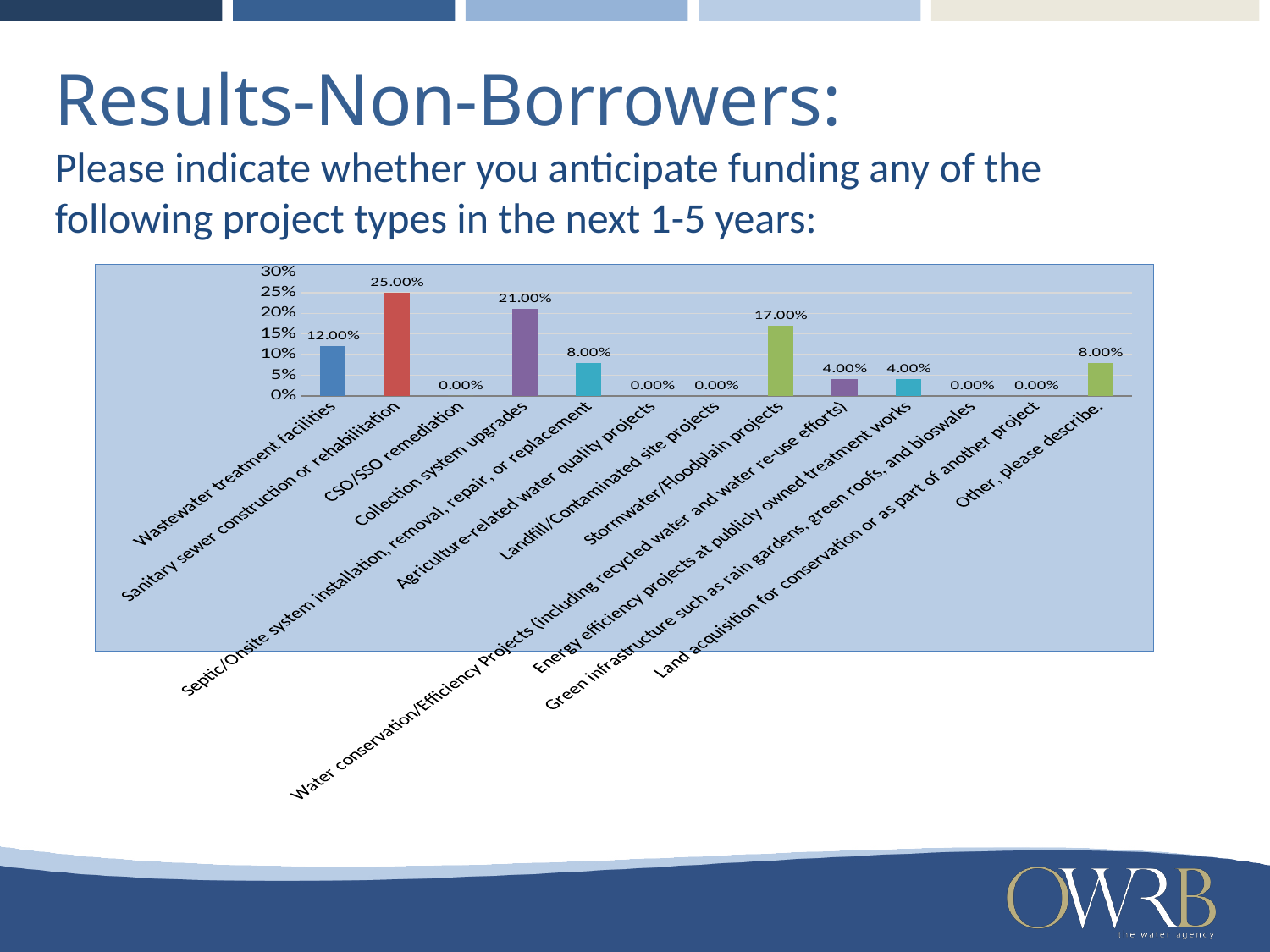
What is the value shown for CSO/SSO remediation? 0.00% What is the value shown for Energy efficiency projects at publicly owned treatment works? 4.00% How many project type categories are shown on the x axis? 13 How many project types have a value of 0.00%? 5 What is the value shown for Collection system upgrades? 21.00% Is the value for Stormwater/Floodplain projects greater or less than 15%? greater What kind of chart is shown on the slide? bar chart What percentage of non-borrowers anticipate funding Wastewater treatment facilities? 12.00% Which is larger, the value for Wastewater treatment facilities or the value for Stormwater/Floodplain projects? Stormwater/Floodplain projects Which project type has the highest value in the chart? Sanitary sewer construction or rehabilitation What is the value shown for Stormwater/Floodplain projects? 17.00% What is the difference between the values for Sanitary sewer construction or rehabilitation and Collection system upgrades? 4.00%